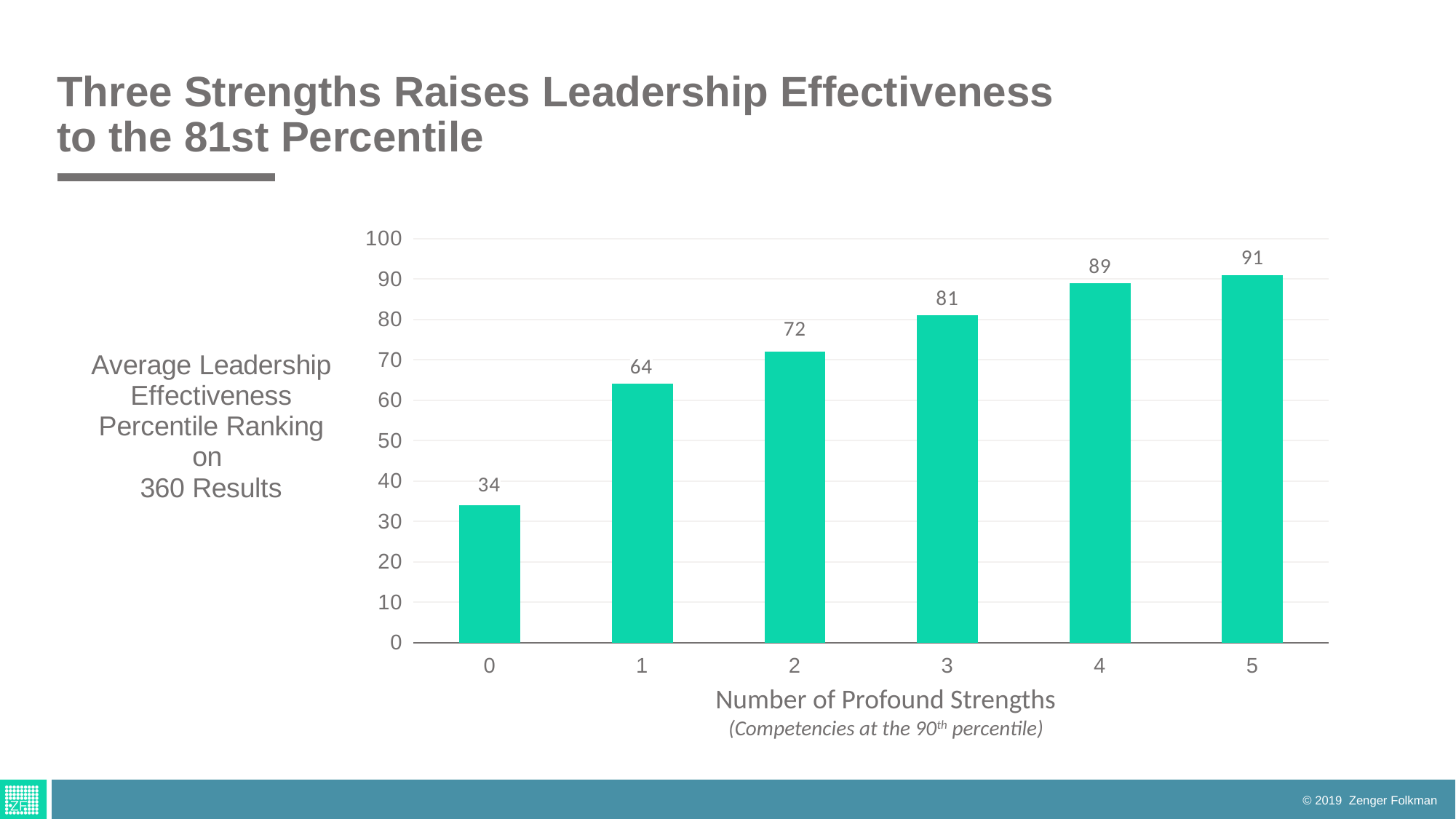
What is the average leadership effectiveness percentile ranking for leaders with 0 profound strengths? 34 What is the difference in percentile ranking between leaders with 5 profound strengths and leaders with 4 profound strengths? 2 Is the percentile ranking for 2 profound strengths greater or less than 60? greater Which number of profound strengths has the highest average leadership effectiveness percentile ranking? 5 Which number of profound strengths has the lowest average leadership effectiveness percentile ranking? 0 What is the average leadership effectiveness percentile ranking for leaders with 3 profound strengths? 81 How many bars are shown in the chart? 6 Which has a higher percentile ranking: 2 profound strengths or 4 profound strengths? 4 profound strengths Do the percentile rankings rise or fall as the number of profound strengths increases? Rise What kind of chart is shown on the slide? Bar chart What is the average leadership effectiveness percentile ranking for leaders with 5 profound strengths? 91 What is the difference in percentile ranking between leaders with 1 profound strength and leaders with 0 profound strengths? 30